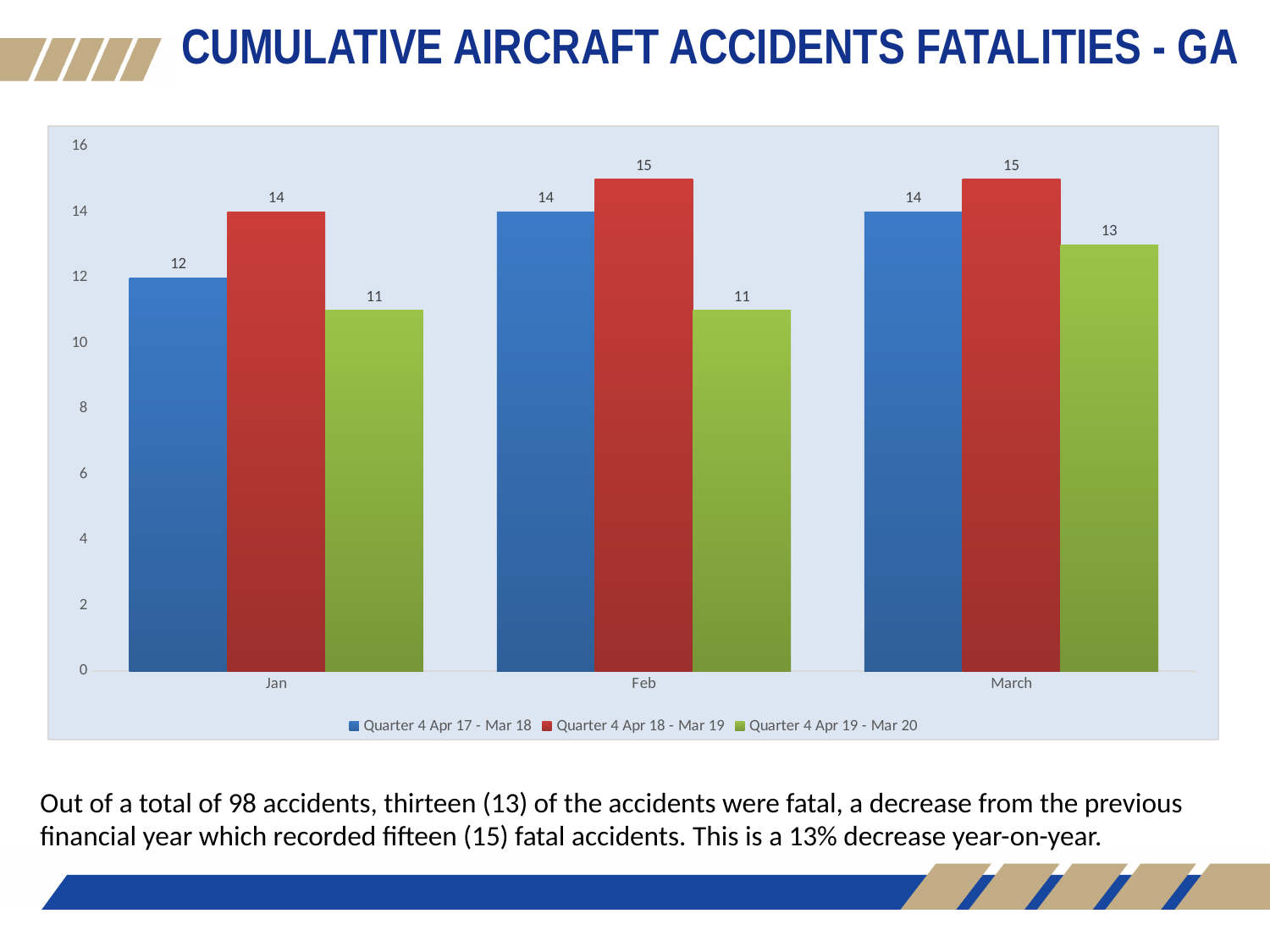
What is the value for Quarter 4 Apr 18 - Mar 19 in Jan? 14 What is the value for Quarter 4 Apr 19 - Mar 20 in March? 13 What is the value for Quarter 4 Apr 17 - Mar 18 in Feb? 14 Is the value for Quarter 4 Apr 19 - Mar 20 in Jan greater or less than 12? less In Jan, which series has the larger value: Quarter 4 Apr 17 - Mar 18 or Quarter 4 Apr 19 - Mar 20? Quarter 4 Apr 17 - Mar 18 Which colour represents Quarter 4 Apr 18 - Mar 19 in the legend? Red Which month has the lowest value for Quarter 4 Apr 17 - Mar 18? Jan How many months are shown on the x axis? 3 What is the difference between the Quarter 4 Apr 18 - Mar 19 and Quarter 4 Apr 19 - Mar 20 values in Feb? 4 How many series does the legend list? 3 What kind of chart is shown on the slide? Bar chart Which month has the highest value for Quarter 4 Apr 19 - Mar 20? March